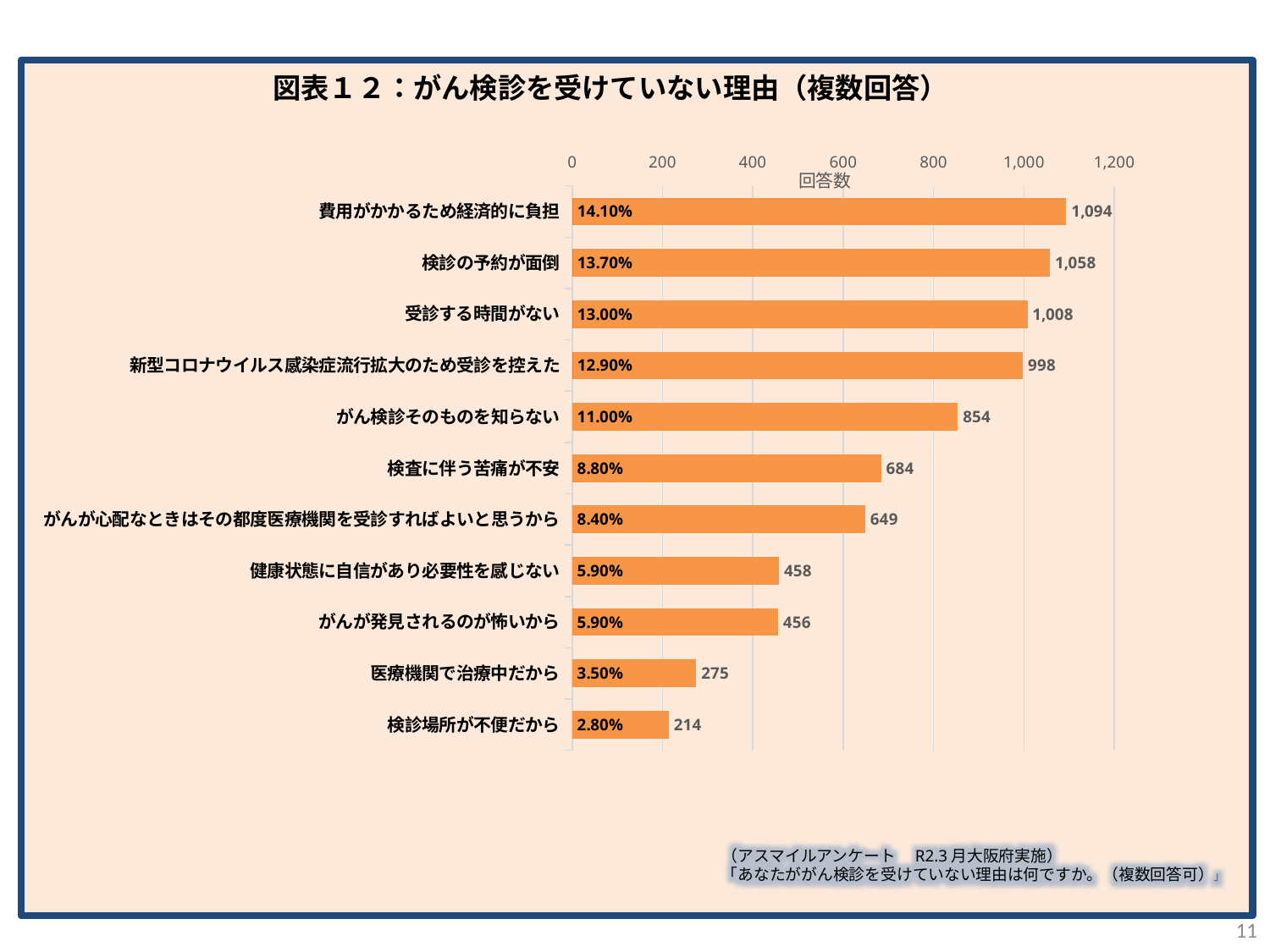
What is the title of the chart? 図表１２：がん検診を受けていない理由（複数回答） What percentage is shown for 検診の予約が面倒? 13.70% Which reason has the highest number of responses? 費用がかかるため経済的に負担 Is the value for がんが発見されるのが怖いから greater or less than 600? less Which reason has the lowest number of responses? 検診場所が不便だから What is the difference in responses between 受診する時間がない and がん検診そのものを知らない? 154 What type of chart is shown on the slide? Bar chart What is the number of responses for 費用がかかるため経済的に負担? 1,094 How many reasons (categories) are shown in the chart? 11 What is the label on the horizontal axis of the chart? 回答数 Which has more responses, 検査に伴う苦痛が不安 or 医療機関で治療中だから? 検査に伴う苦痛が不安 What is the number of responses for 新型コロナウイルス感染症流行拡大のため受診を控えた? 998